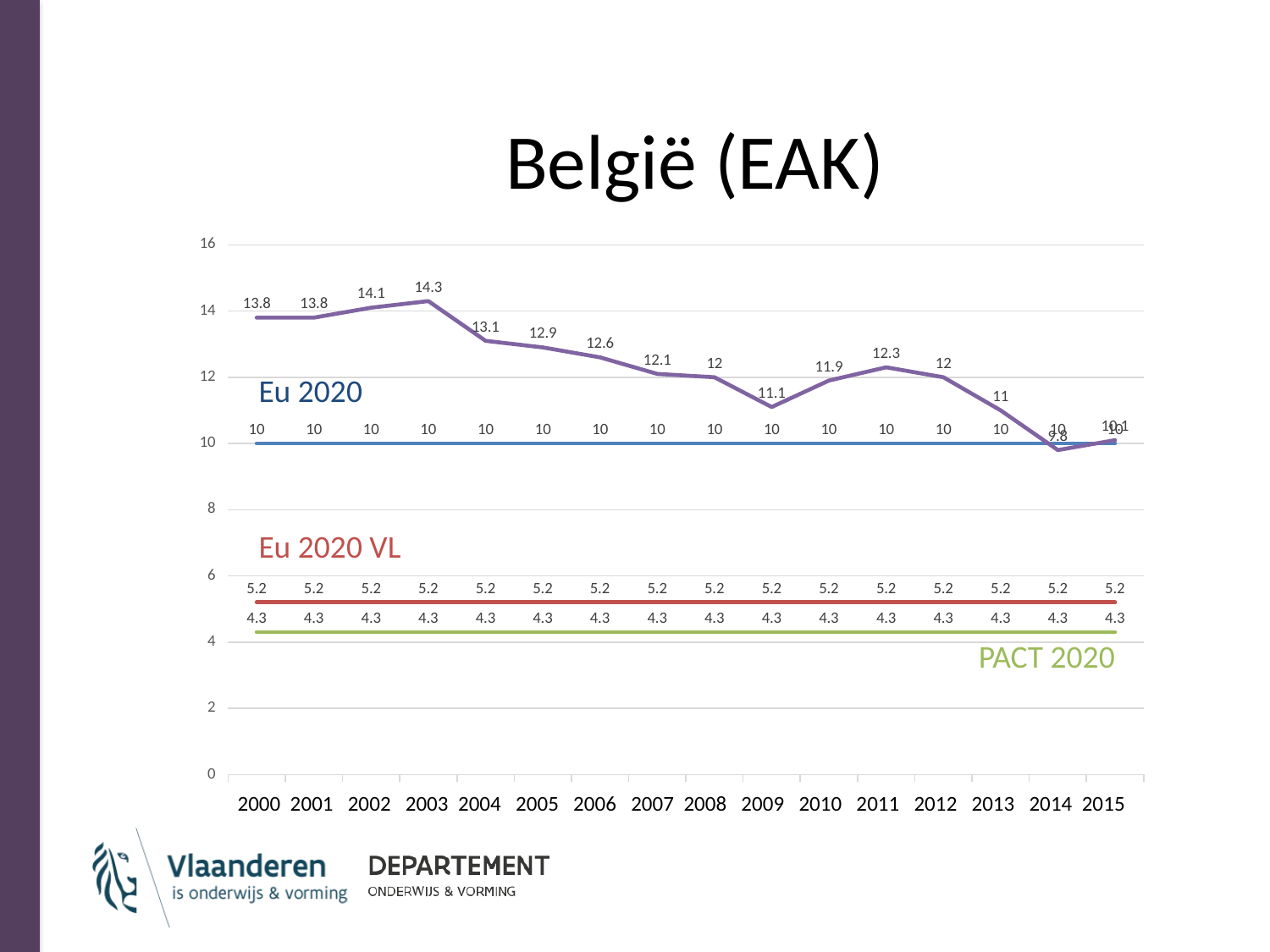
How many years are shown along the x axis? 16 What is the title of the chart? België (EAK) What is the value of the Eu 2020 VL line in 2005? 5.2 What is the value of the purple line in 2009? 11.1 What is the value of the PACT 2020 line in 2015? 4.3 In which year does the purple line reach its highest value? 2003 What is the value of the purple line in 2003? 14.3 In which year does the purple line reach its lowest value? 2014 What is the value of the Eu 2020 line in 2010? 10 What is the difference between the purple line's value in 2003 and its value in 2014? 4.5 Does the purple line generally rise or fall from 2003 to 2014? fall What kind of chart is shown on the slide? line chart